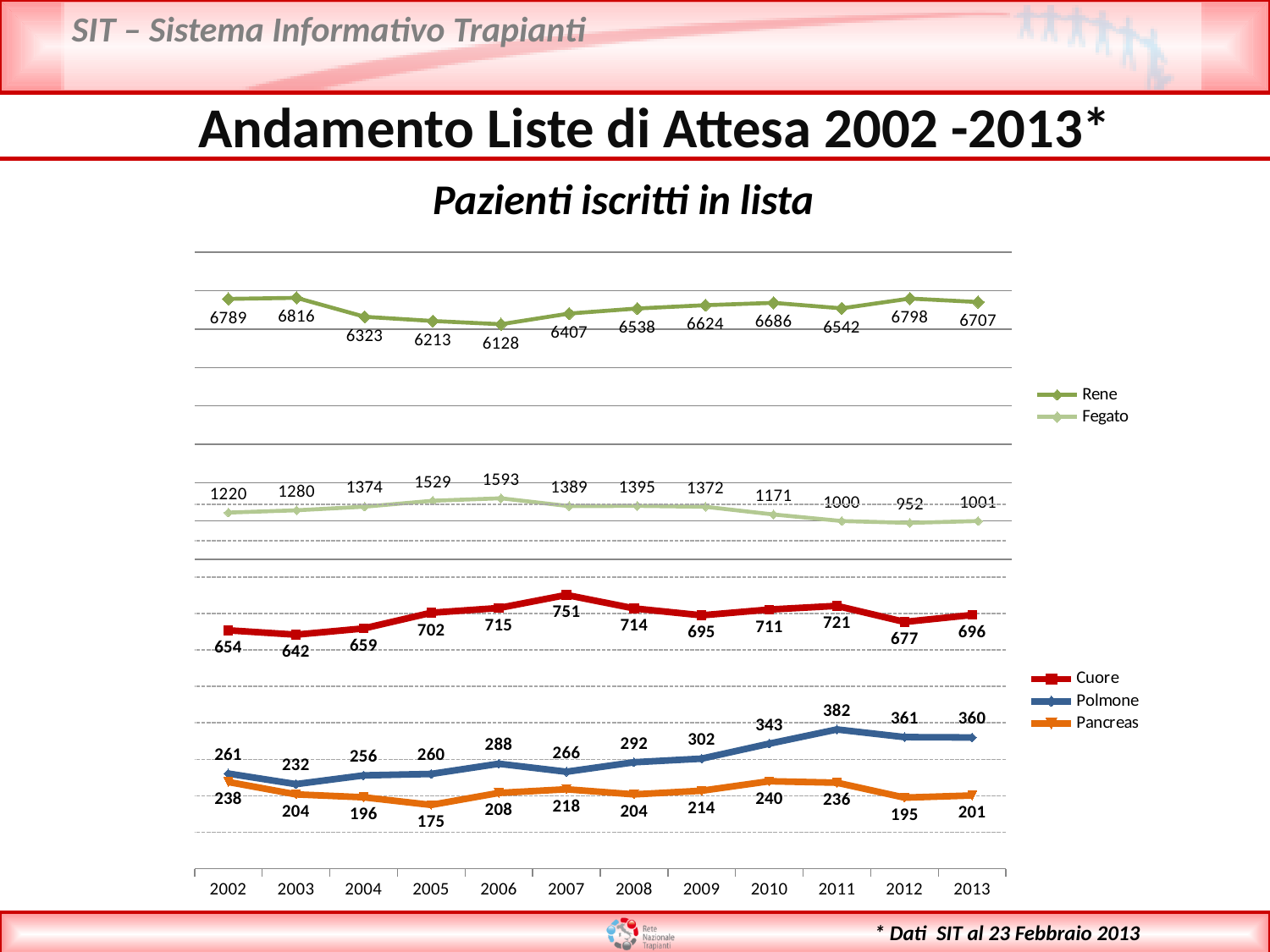
In the bottom chart, what is the value for Cuore in 2007? 751 In the bottom chart, which is larger in 2002: Polmone or Pancreas? Polmone In the top chart, which year has the highest value for Fegato? 2006 In the top chart, which year has the lowest value for Rene? 2006 In the bottom chart, which year has the highest value for Polmone? 2011 In the top chart, what is the difference between the Rene values for 2003 and 2002? 27 In the top chart, what is the value for Rene in 2006? 6128 What kind of chart is the top chart? Line chart In the bottom chart, what is the difference between the Polmone values for 2011 and 2010? 39 How many series does the legend of the bottom chart list? 3 In the bottom chart, what is the value for Pancreas in 2005? 175 In the top chart, what is the value for Fegato in 2012? 952